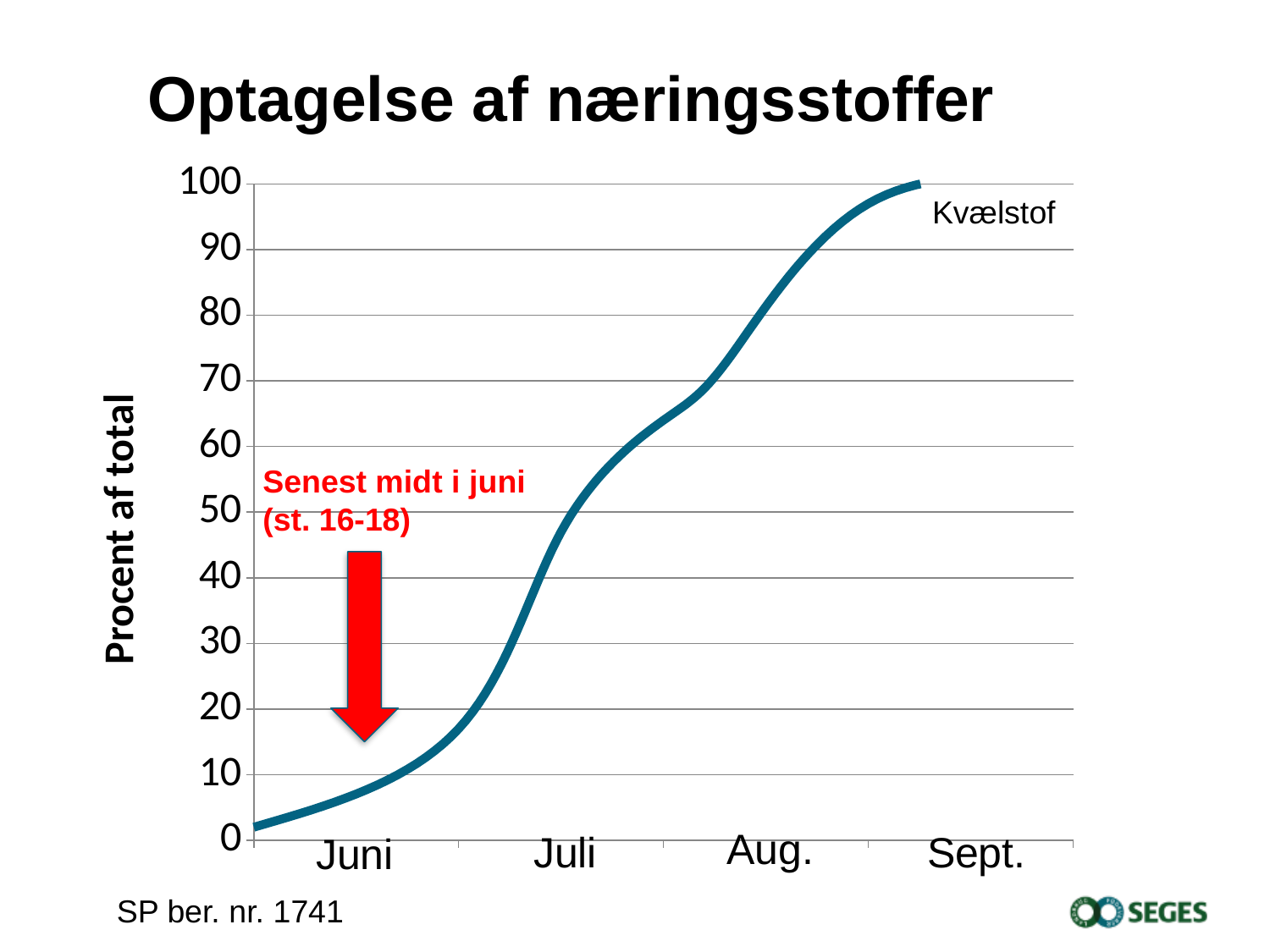
Is the Kvælstof value at the right end of the line greater or less than 90? greater Is the Kvælstof value at Aug. greater or less than 60? greater Is the Kvælstof value at Juli greater or less than 40? greater What kind of chart is shown on the slide? line chart Does the Kvælstof line rise or fall from Juni to Sept.? rises How many series are plotted in the chart? 1 What is the title of the chart? Optagelse af næringsstoffer How many month labels are shown on the x axis? 4 Is the Kvælstof value higher at Juli or at Juni? Juli What is the label on the y axis of the chart? Procent af total Is the Kvælstof value higher at Juni or at Aug.? Aug.